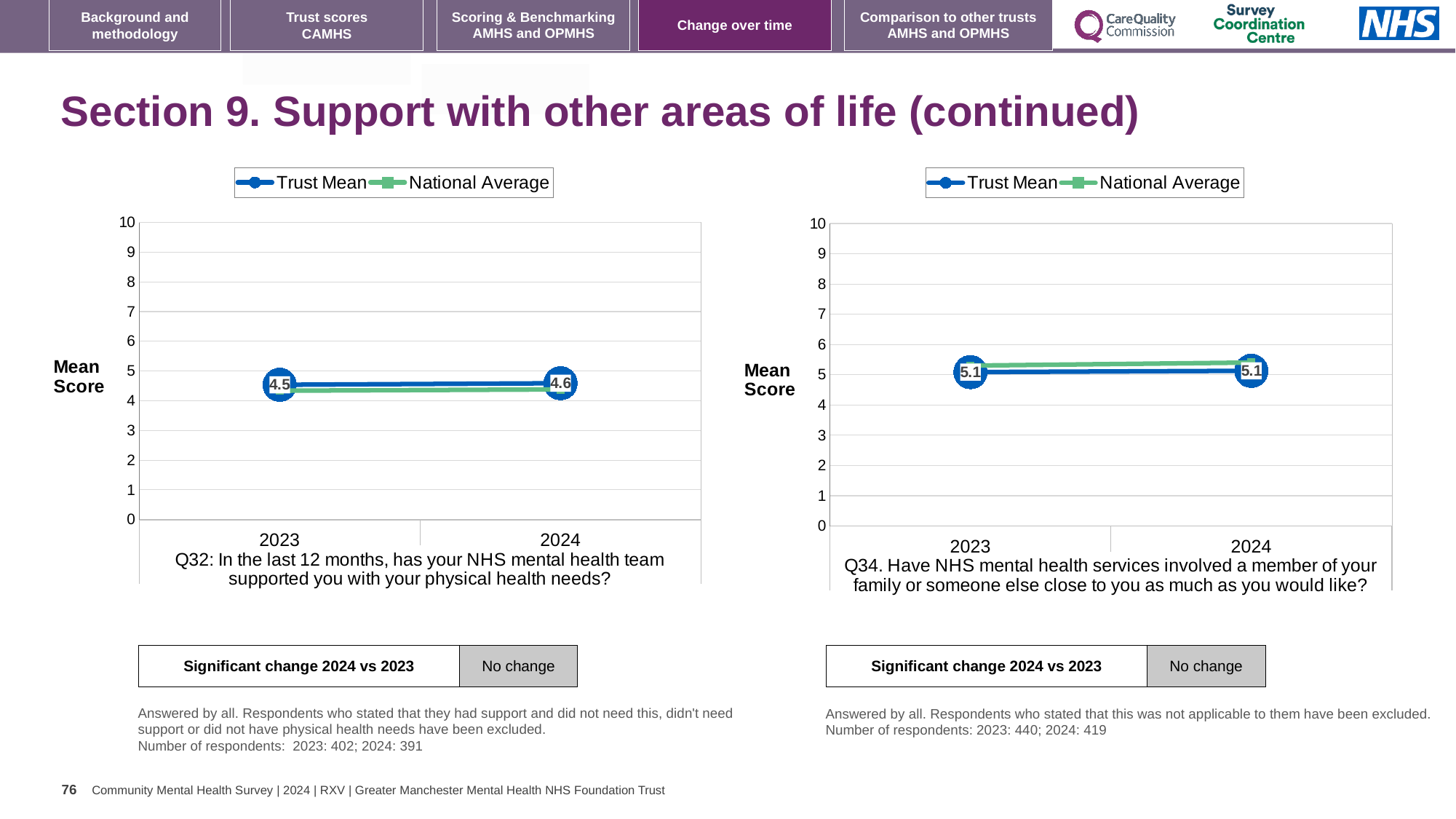
What are the two series named in the legend of the left chart (Q32)? Trust Mean and National Average In the left chart (Q32), what is the difference between the Trust Mean for 2024 and 2023? 0.1 How many series does the legend of the right chart (Q34) list? 2 In the right chart (Q34), is the National Average for 2024 greater or less than 5? greater In the left chart (Q32), does the Trust Mean rise or fall from 2023 to 2024? rise In the left chart (Q32), what is the Trust Mean for 2023? 4.5 How many years are plotted on the x axis of the left chart (Q32)? 2 What kind of chart is the left chart (Q32)? line chart In the right chart (Q34), does the Trust Mean change between 2023 and 2024? No, it stays at 5.1 In the left chart (Q32), what is the Trust Mean for 2024? 4.6 In the left chart (Q32), is the National Average for 2023 greater or less than 5? less In the right chart (Q34), what is the Trust Mean for 2024? 5.1